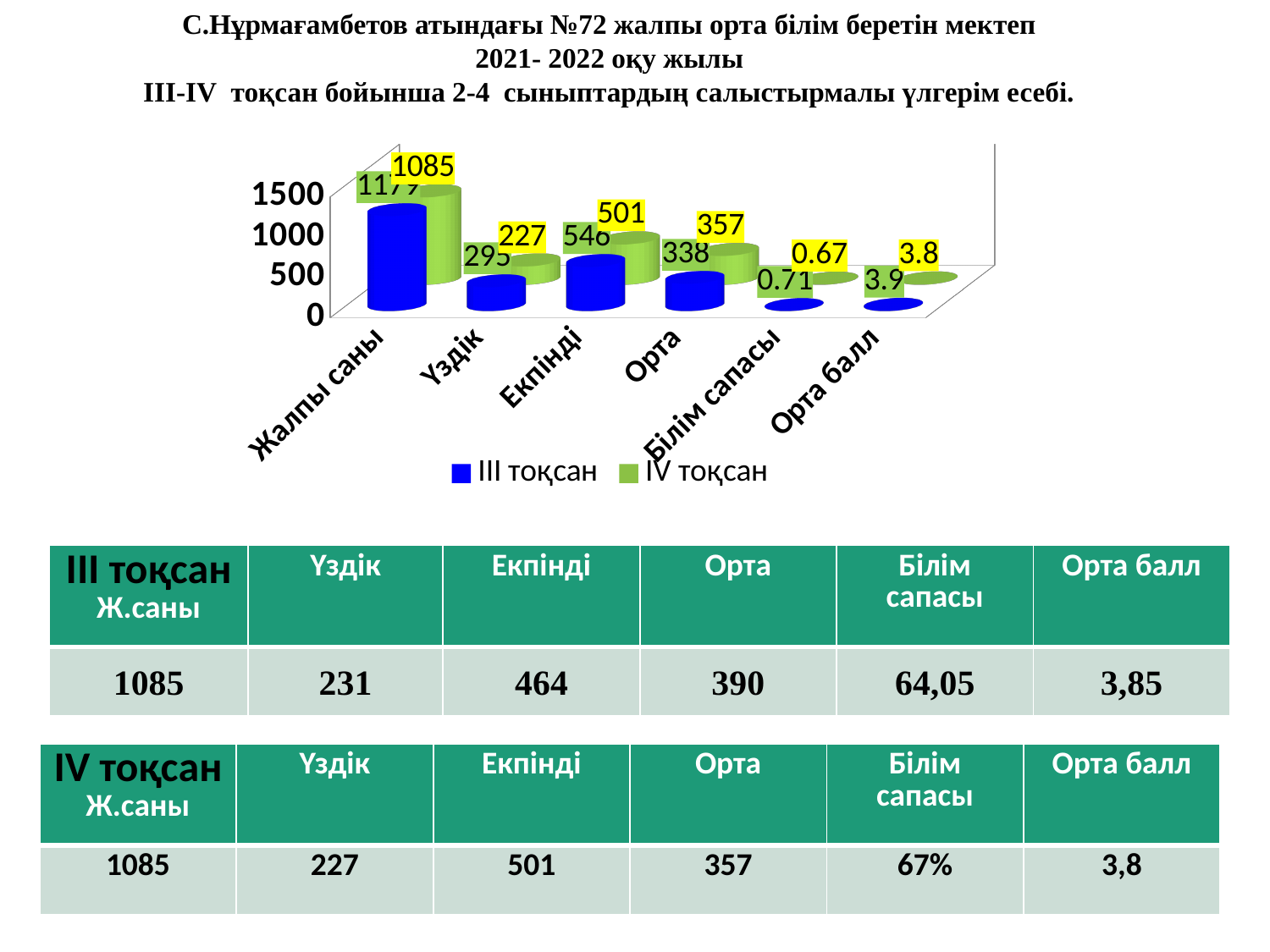
What is the IV тоқсан value for Орта балл in the chart? 3.8 What is the IV тоқсан value for Екпінді in the chart? 501 What is the III тоқсан value for Білім сапасы in the chart? 0.71 How many series does the chart legend list? 2 For Орта, which series has the larger value in the chart, III тоқсан or IV тоқсан? IV тоқсан Which category has the highest IV тоқсан value in the chart? Жалпы саны What is the IV тоқсан value for Жалпы саны in the chart? 1085 What colour are the III тоқсан bars in the chart? blue How many categories are plotted along the x axis of the chart? 6 What is the III тоқсан value for Орта in the chart? 338 What is the difference between the IV тоқсан and III тоқсан values for Орта in the chart? 19 What kind of chart is shown on the slide? bar chart